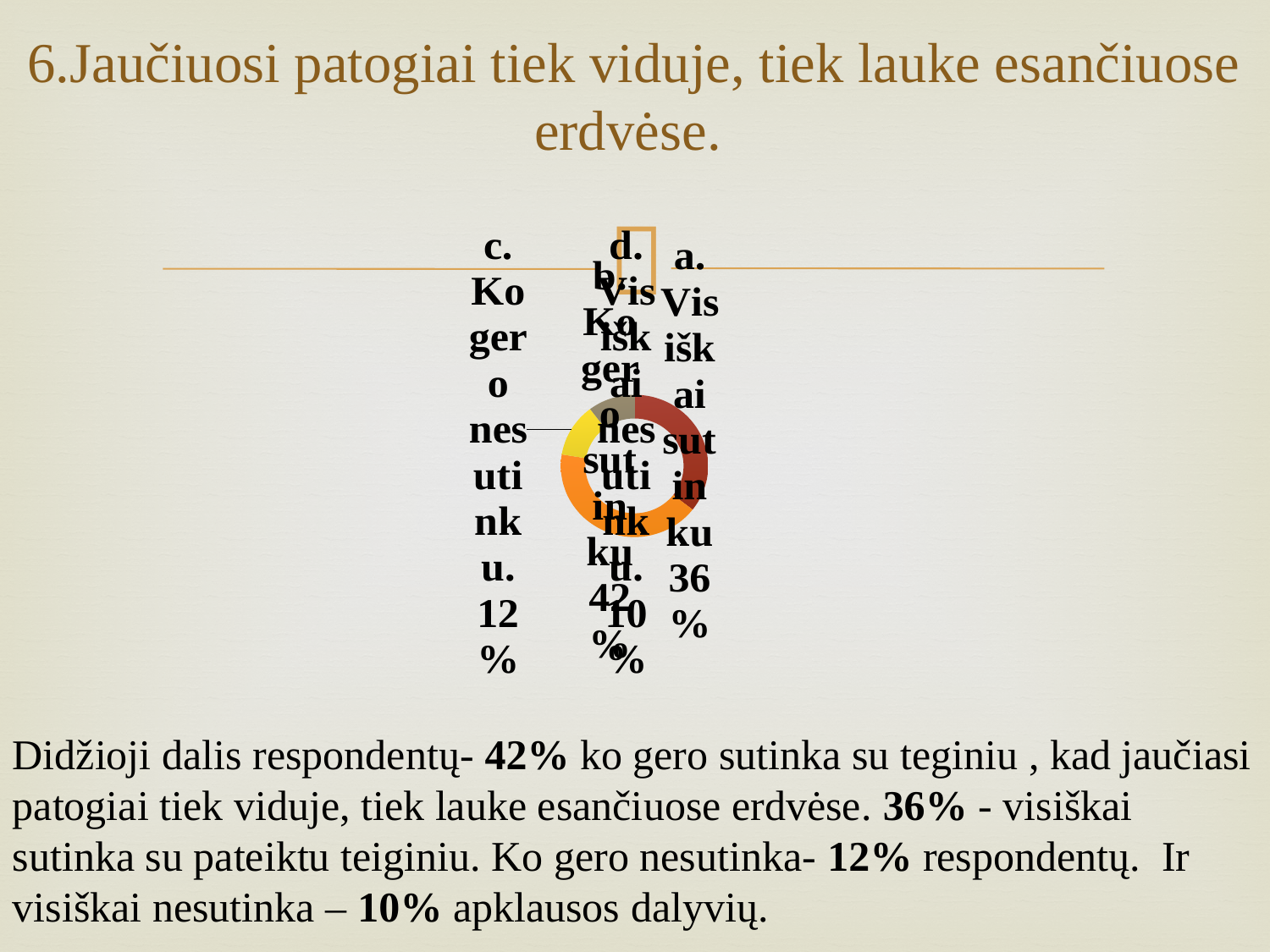
Which is larger: the share for "c. Ko gero nesutinku" or for "d. Visiškai nesutinku"? c. Ko gero nesutinku What share of respondents answered "b. Ko gero sutinku"? 42% How many categories does the doughnut chart show? 4 What share of respondents answered "a. Visiškai sutinku"? 36% What is the difference in percentage points between "b. Ko gero sutinku" and "a. Visiškai sutinku"? 6 What is the combined share of "a. Visiškai sutinku" and "b. Ko gero sutinku"? 78% What kind of chart is shown on the slide? doughnut chart Which answer category has the smallest share in the chart? d. Visiškai nesutinku Which answer category has the largest share in the chart? b. Ko gero sutinku What share of respondents answered "d. Visiškai nesutinku"? 10% What is the title of the slide containing the chart? 6.Jaučiuosi patogiai tiek viduje, tiek lauke esančiuose erdvėse. What share of respondents answered "c. Ko gero nesutinku"? 12%